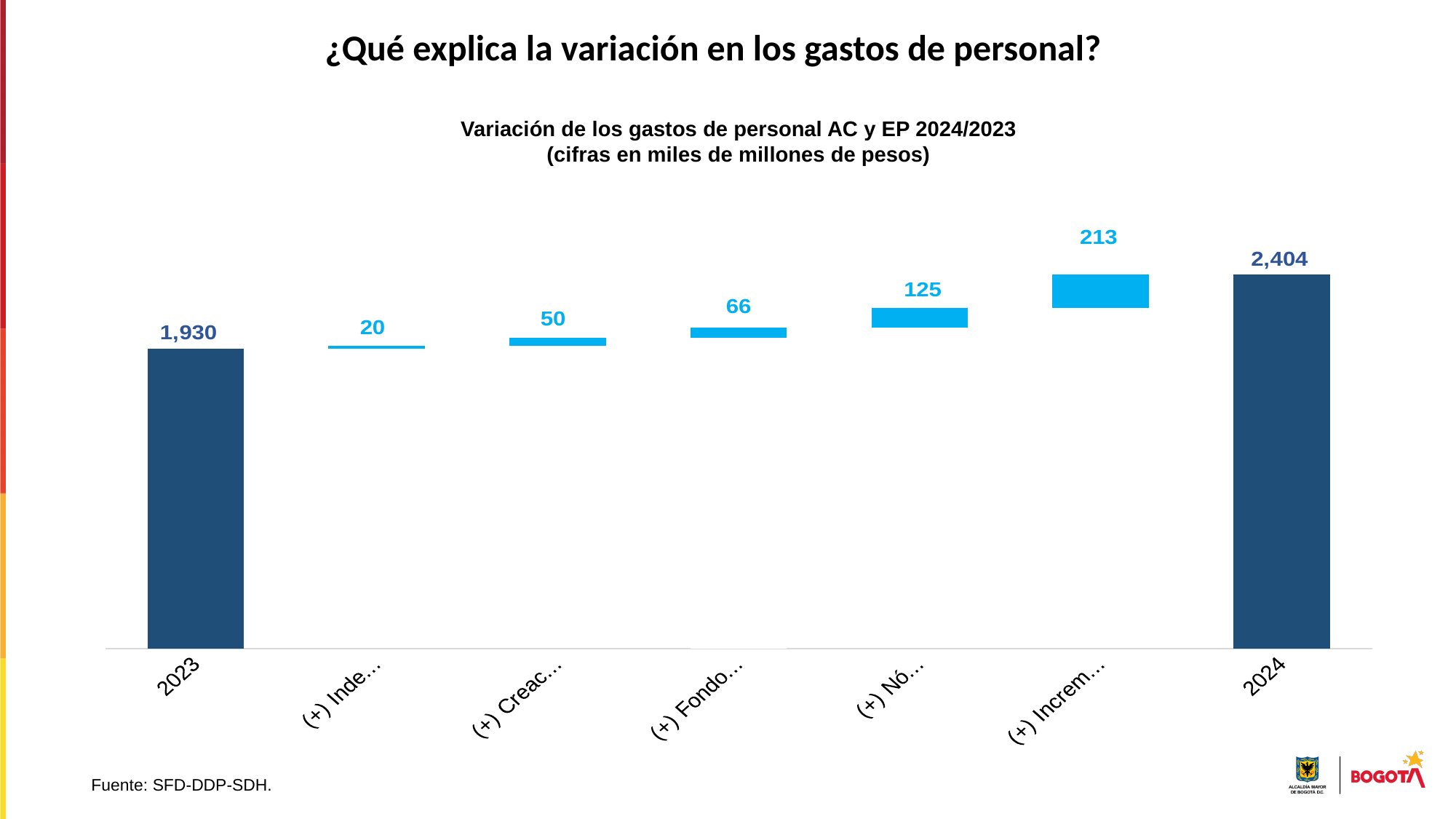
What is the value of the bar labelled '(+) Fondo…'? 66 How many categories are shown on the x axis? 7 What is the value of the bar labelled '(+) Increm…'? 213 Which is larger, the value for 2024 or the value for 2023? 2024 What is the value of the bar labelled '(+) Nó…'? 125 What is the difference between the 2024 value and the 2023 value? 474 What is the value shown for 2023? 1,930 What unit is stated in the chart subtitle? miles de millones de pesos Which of the intermediate (+) bars has the smallest value? (+) Inde… (20) What kind of chart is this? Waterfall (bar) chart Which of the intermediate (+) bars has the largest value? (+) Increm… (213) What is the value shown for 2024? 2,404